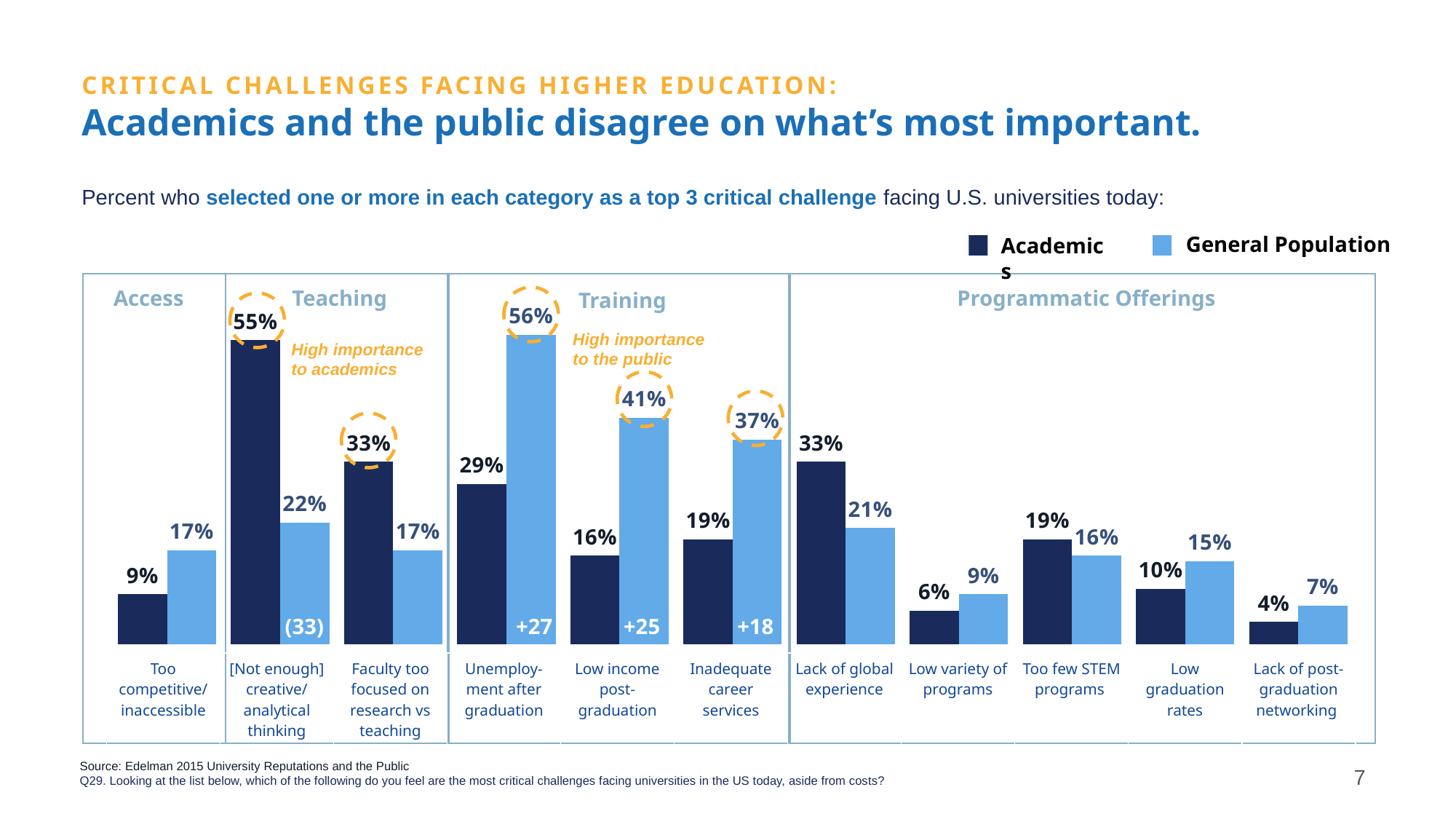
For 'Inadequate career services', which is larger: the Academics value or the General Population value? General Population What is the General Population value for 'Low income post-graduation'? 41% Which category has the highest value for the General Population series? Unemployment after graduation What percentage of Academics selected '[Not enough] creative/analytical thinking' as a top 3 critical challenge? 55% What percentage of the General Population selected 'Unemployment after graduation' as a top 3 critical challenge? 56% How many challenge categories are shown on the x axis of the chart? 11 How many series does the chart legend list? 2 For 'Too few STEM programs', which is larger: the Academics value or the General Population value? Academics What kind of chart is shown on the slide? Bar chart Which category has the lowest value for the Academics series? Lack of post-graduation networking Which group of challenges is labelled 'Programmatic Offerings' on the chart? Lack of global experience, Low variety of programs, Too few STEM programs, Low graduation rates, Lack of post-graduation networking What is the difference between the Academics and General Population values for 'Faculty too focused on research vs teaching'? 16 percentage points